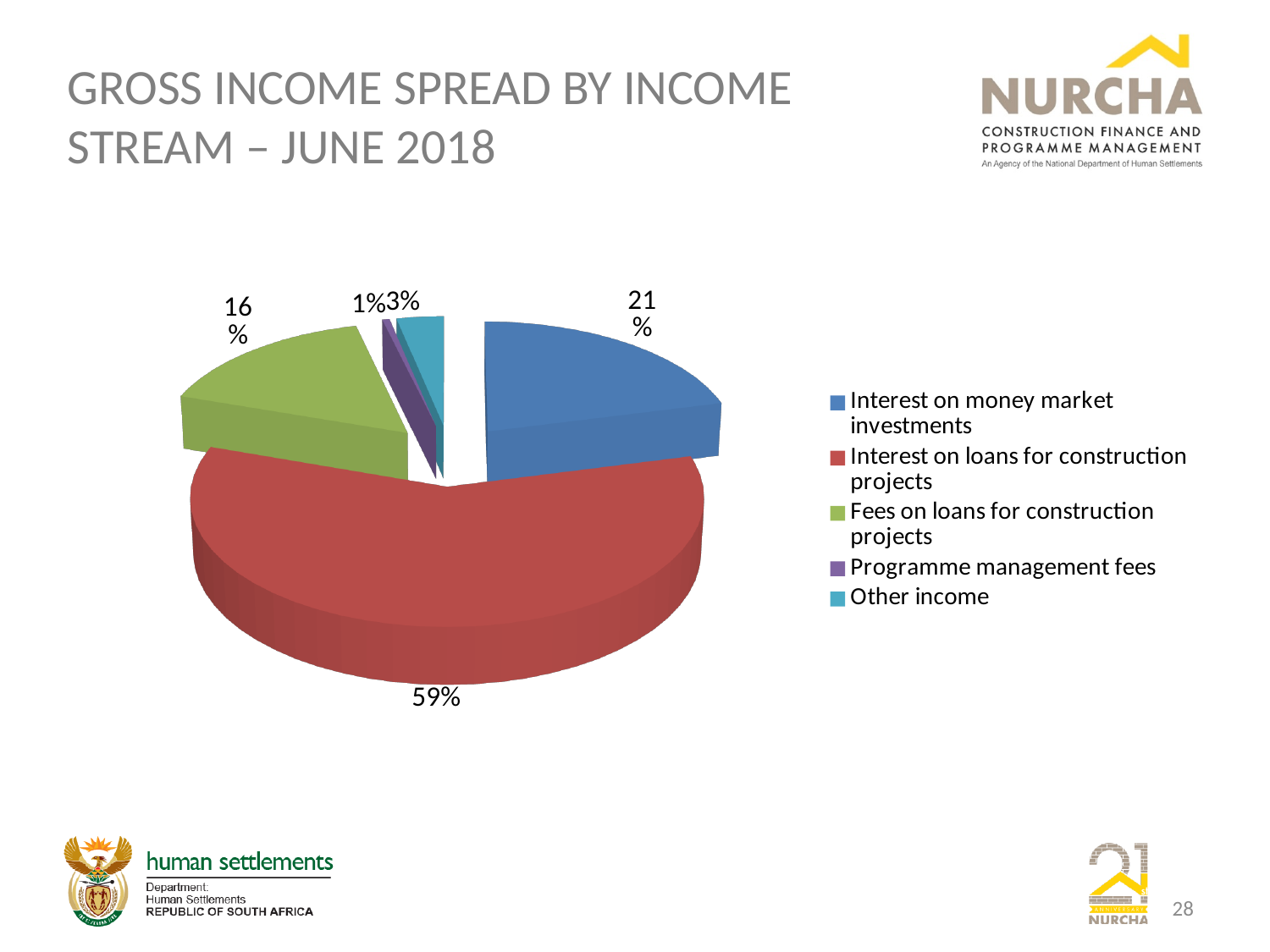
What kind of chart is shown on the slide? Pie chart What is the difference in percentage points between interest on loans for construction projects and interest on money market investments? 38 What share of gross income comes from interest on money market investments? 21% Which is larger: the share for fees on loans for construction projects or the share for other income? Fees on loans for construction projects Which income stream has the smallest share of gross income? Programme management fees What share of gross income comes from fees on loans for construction projects? 16% What share of gross income comes from other income? 3% What is the title of the chart on the slide? Gross income spread by income stream – June 2018 How many income streams does the legend list? 5 Which income stream has the largest share of gross income? Interest on loans for construction projects